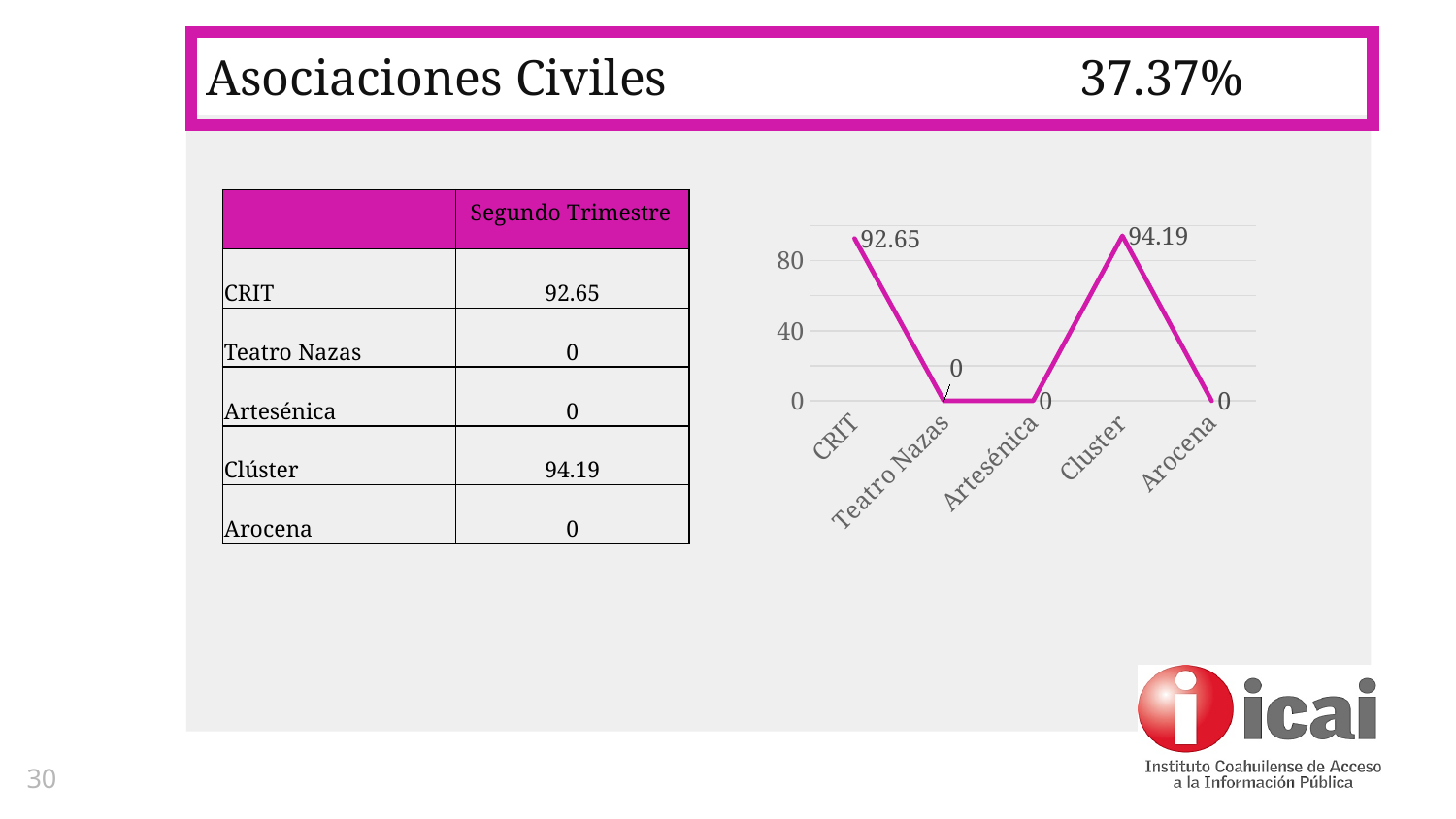
What is the difference between the values for Cluster and CRIT? 1.54 What is the value for Arocena in the chart? 0 What is the value for Teatro Nazas in the chart? 0 What colour is the line in the chart? Magenta How many categories are plotted along the x axis of the chart? 5 Which category has the highest value in the chart? Cluster How many categories in the chart have a value of 0? 3 Is the value for CRIT greater or less than 80? greater What is the value for CRIT in the chart? 92.65 What type of chart is shown on the slide? Line chart What is the value for Cluster in the chart? 94.19 Which is larger, the value for CRIT or the value for Artesénica? CRIT